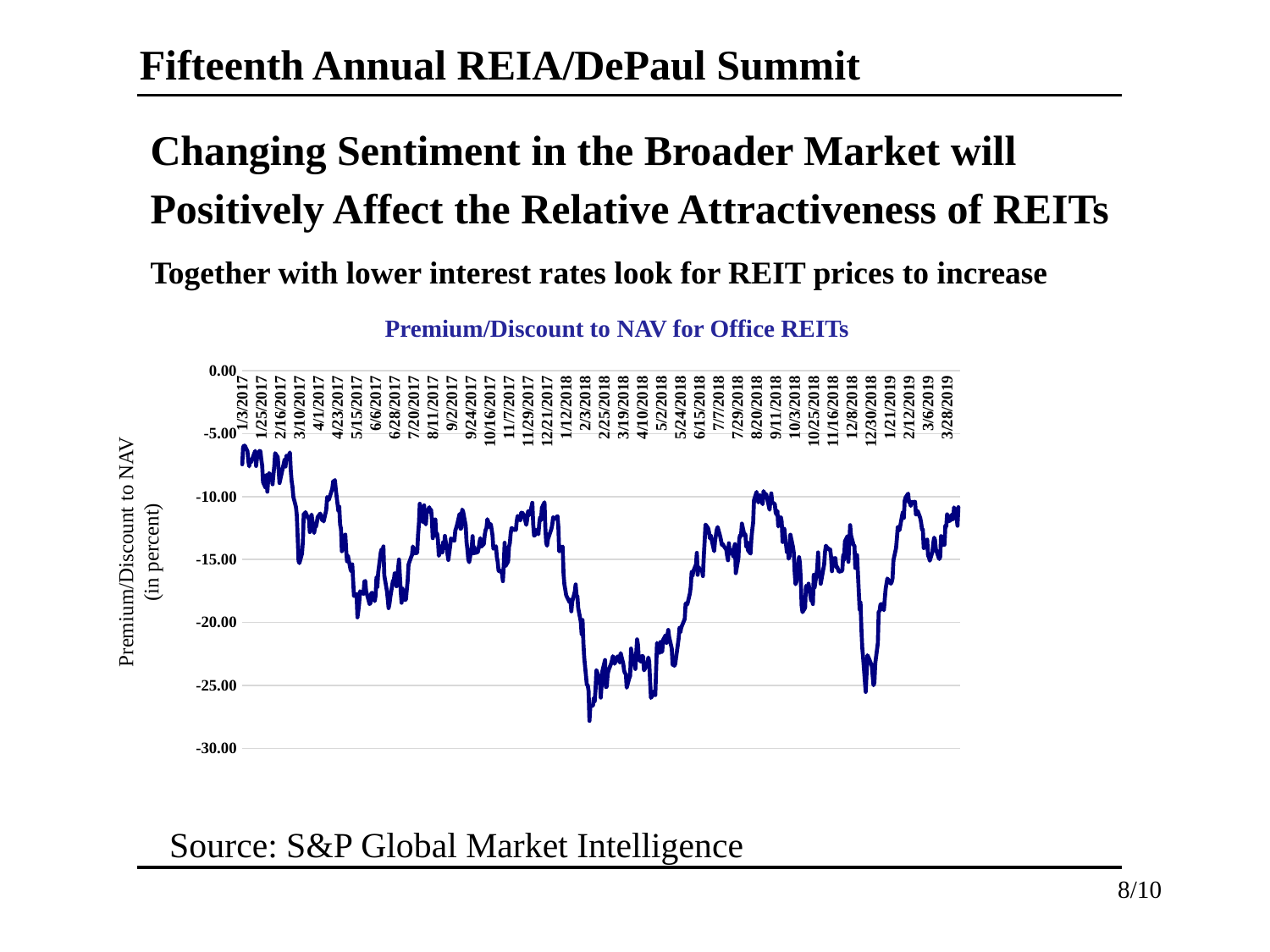
Is the value around 8/20/2018 greater or less than -15.00? greater Do the values generally rise or fall from 1/3/2017 to 2/3/2018? fall Is the value around 5/15/2017 greater or less than -15.00? less What is the title of the chart? Premium/Discount to NAV for Office REITs Is the value at 1/3/2017 greater or less than -10.00? greater What kind of chart is shown on the slide? line chart What is the label on the vertical axis of the chart? Premium/Discount to NAV (in percent) Do the values generally rise or fall from 2/3/2018 to 8/20/2018? rise How many data series are plotted in the chart? 1